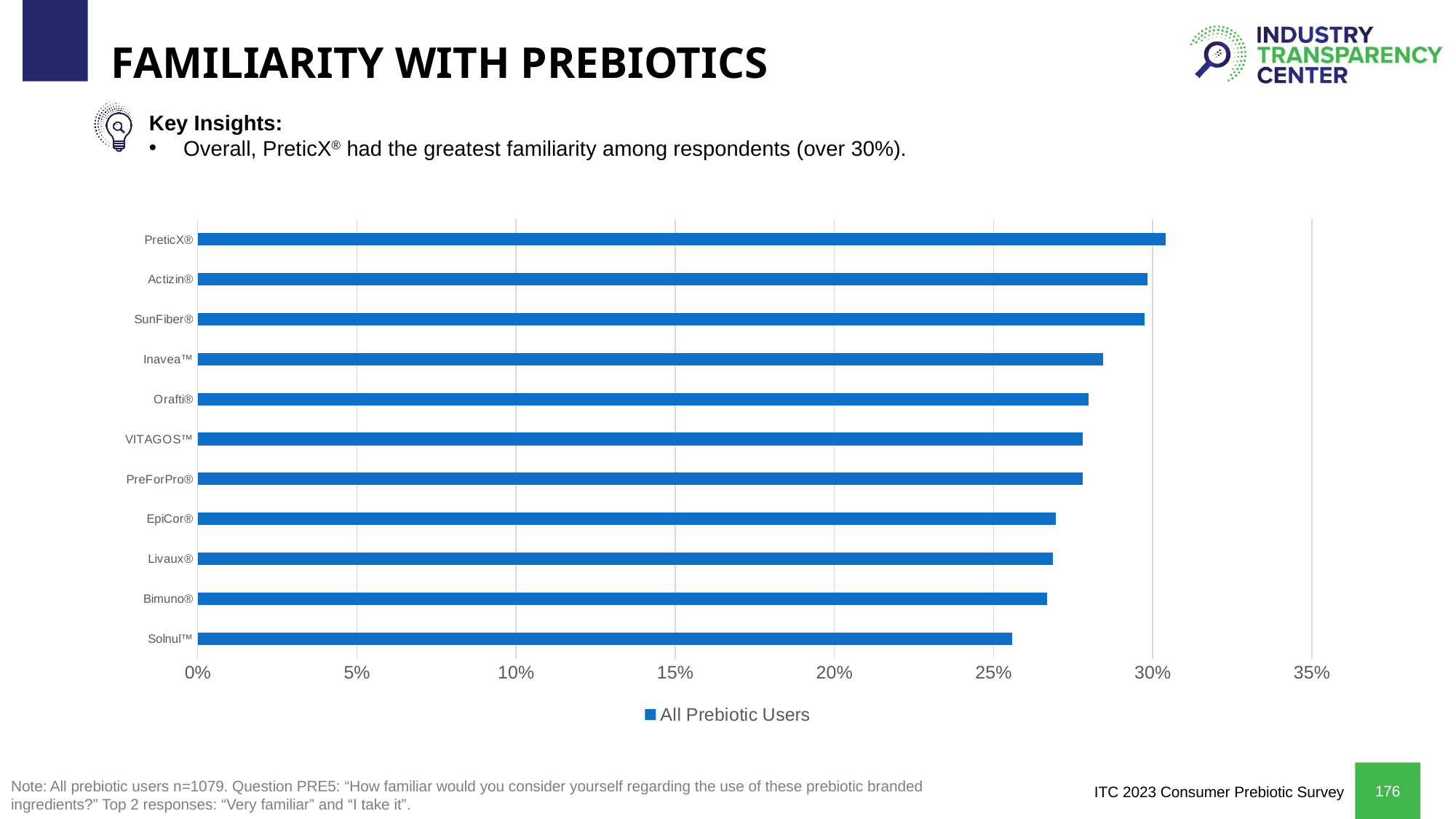
Which has a larger value, PreticX® or Solnul™? PreticX® Is the value for Inavea™ greater or less than 30%? less Is the value for PreticX® greater or less than 30%? greater Which brand has the highest familiarity value on the chart? PreticX® Is the value for Solnul™ greater or less than 25%? greater How many series does the legend list? 1 How many prebiotic brands are listed on the chart? 11 What is the name of the series shown in the legend? All Prebiotic Users Which brand has the lowest familiarity value on the chart? Solnul™ Which has a larger value, Inavea™ or EpiCor®? Inavea™ What kind of chart is shown on the slide? bar chart